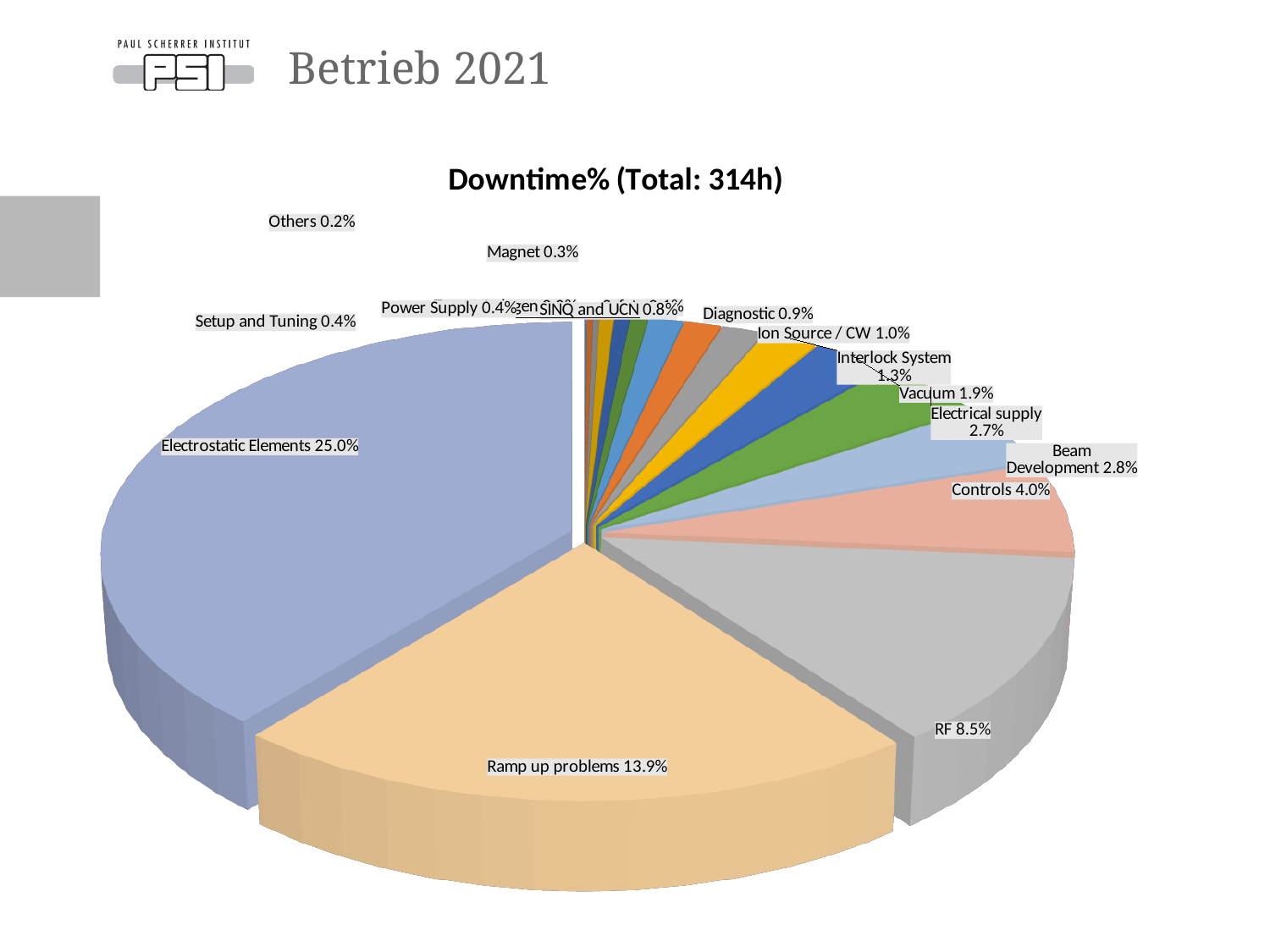
What is the value shown for Vacuum? 1.9% What is the value shown for RF? 8.5% What is the difference between the values for Electrostatic Elements and Ramp up problems? 11.1% Which is larger, the value for Beam Development or the value for Electrical supply? Beam Development Which category has the largest share of the pie? Electrostatic Elements What is the value shown for Ramp up problems? 13.9% What is the title of the chart? Downtime% (Total: 314h) What is the value shown for Electrostatic Elements? 25.0% What is the value shown for Controls? 4.0% What total number of hours is stated in the chart title? 314h What type of chart is shown on the slide? pie chart